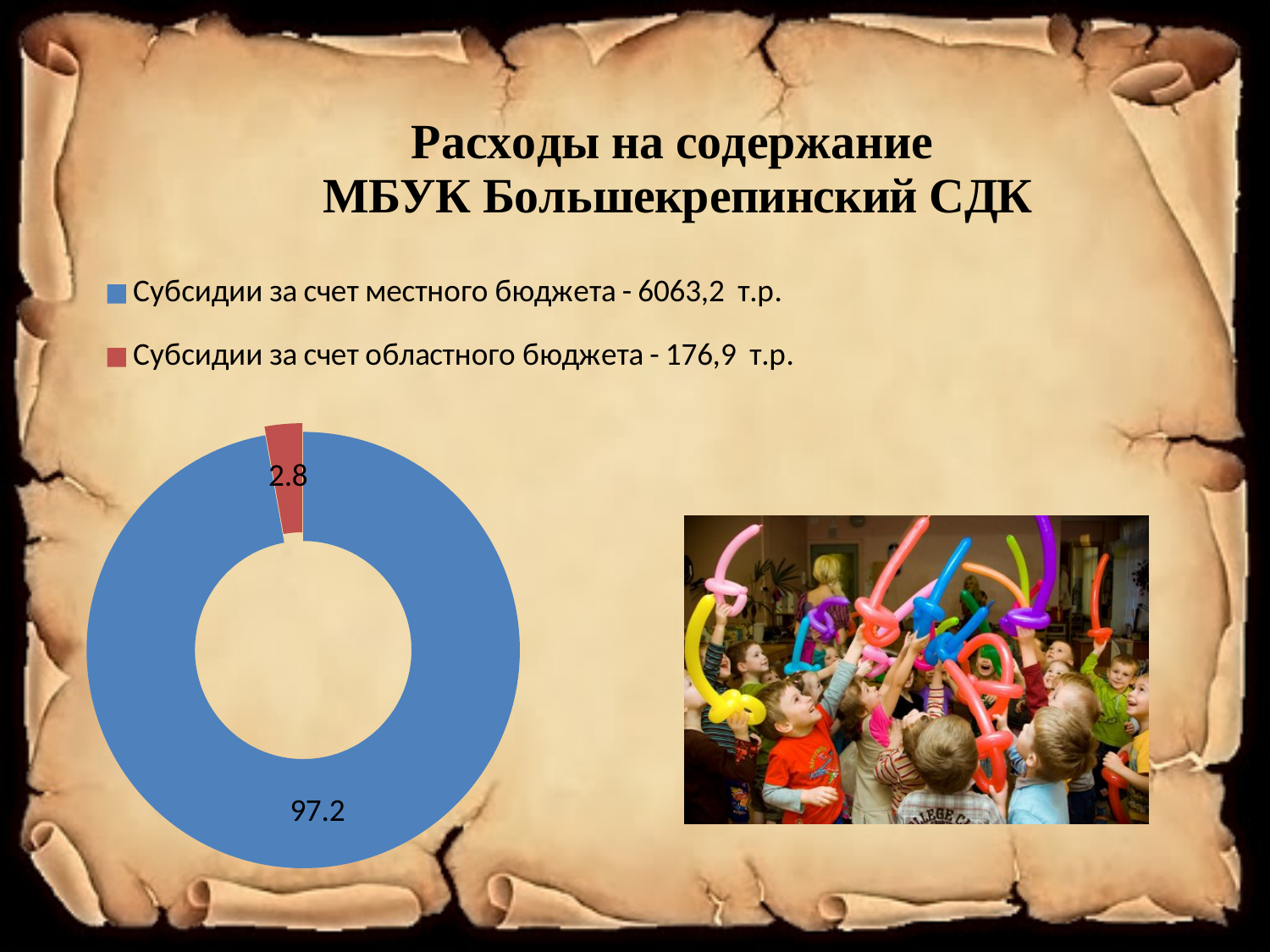
Which category has the largest slice in the chart? Субсидии за счет местного бюджета What kind of chart is shown on the slide? Doughnut (pie) chart Which is larger: the slice for 'Субсидии за счет местного бюджета' or the slice for 'Субсидии за счет областного бюджета'? Субсидии за счет местного бюджета What is the difference between the values labelled 97.2 and 2.8 on the chart? 94.4 Which category has the smallest slice in the chart? Субсидии за счет областного бюджета What is the title of the chart on the slide? Расходы на содержание МБУК Большекрепинский СДК How many slices does the chart have? 2 According to the legend, what amount in т.р. corresponds to 'Субсидии за счет местного бюджета'? 6063,2 т.р. What value is shown on the chart for the slice 'Субсидии за счет областного бюджета'? 2.8 What is the sum of the two values labelled on the chart? 100 What value is shown on the chart for the slice 'Субсидии за счет местного бюджета'? 97.2 According to the legend, what amount in т.р. corresponds to 'Субсидии за счет областного бюджета'? 176,9 т.р.